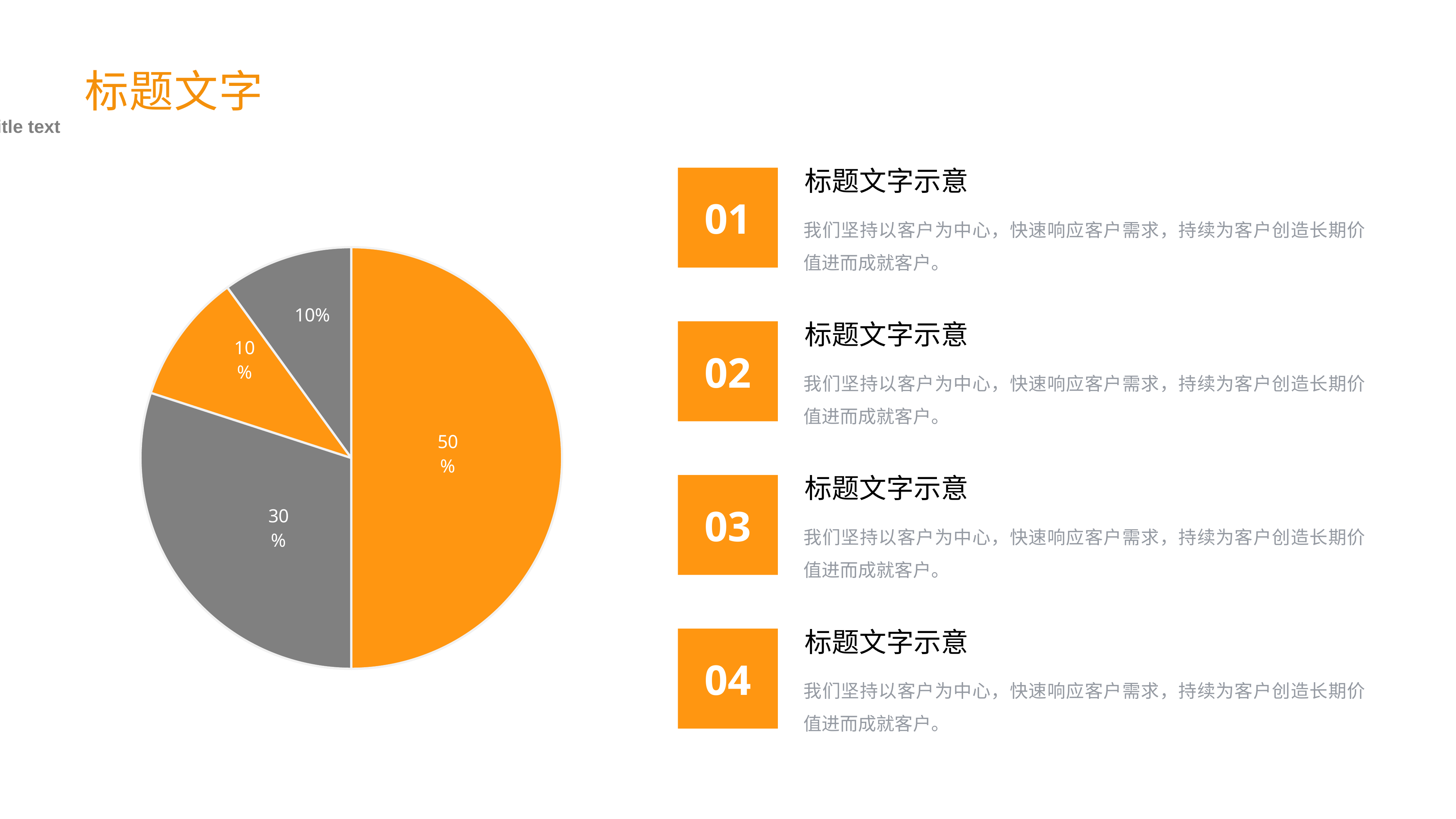
How many slices in the pie chart are labelled 10%? 2 What kind of chart is shown on the left of the slide? pie chart What do the two smallest slices of the pie chart add up to? 20% What is the smallest value labelled on the pie chart? 10% Which is larger in the pie chart: the large orange slice or the large gray slice? the large orange slice How many slices does the pie chart have? 4 What value is labelled on the large gray slice of the pie chart? 30% What share of the pie does the largest slice represent? 50% What is the difference between the largest slice (50%) and the large gray slice (30%) in the pie chart? 20% What value is labelled on the large orange slice on the right half of the pie chart? 50% Which two colours are used for the slices of the pie chart? orange and gray What is the value of the largest slice in the pie chart? 50%